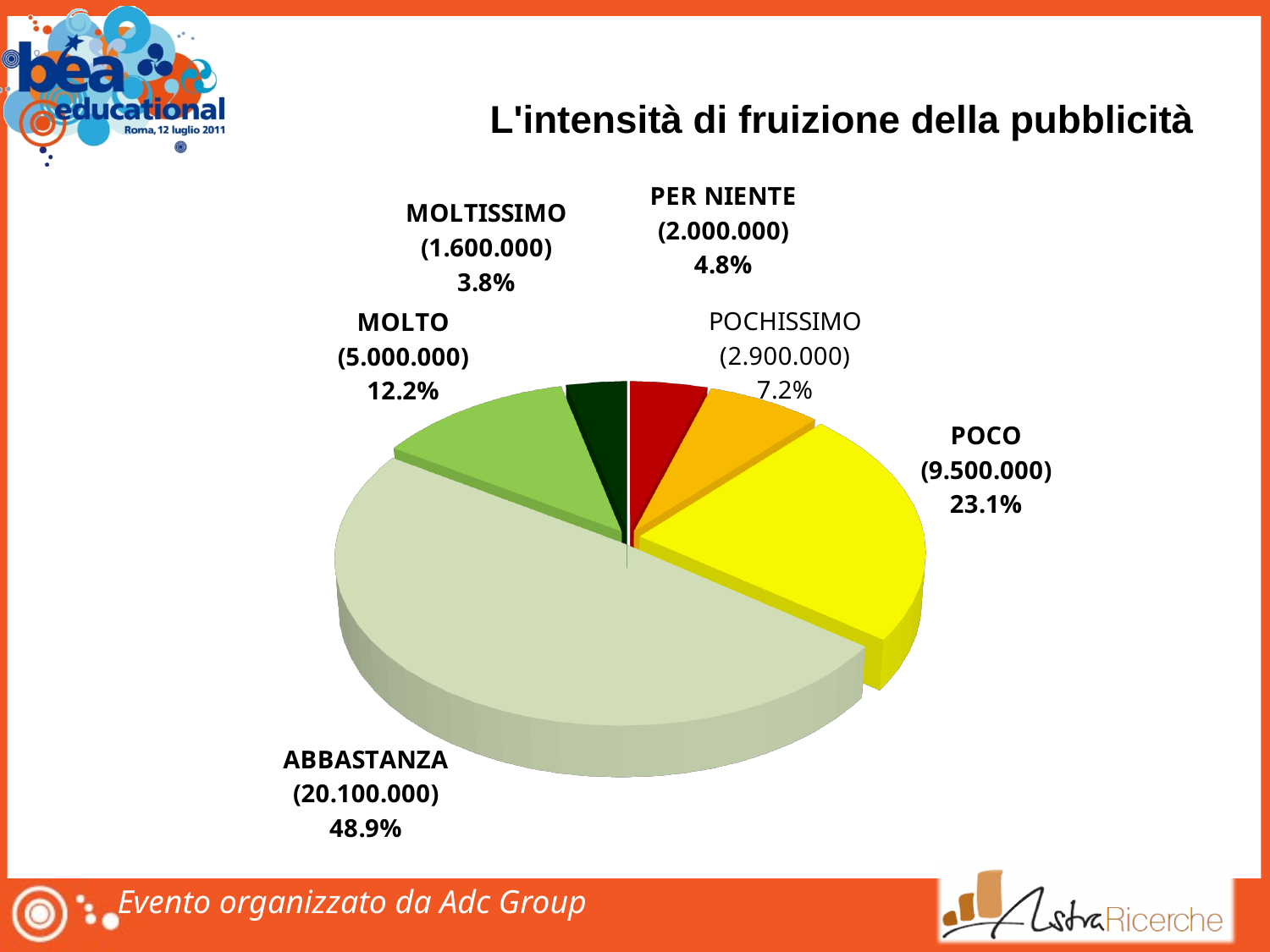
How many slices does the pie chart have? 6 Which category has the largest slice? ABBASTANZA What percentage share does the ABBASTANZA slice have? 48.9% What kind of chart is shown on the slide? pie chart What is the title of the chart? L'intensità di fruizione della pubblicità What percentage is shown for MOLTO? 12.2% What is the value shown for POCO? 9.500.000 Which is larger, POCHISSIMO or PER NIENTE? POCHISSIMO What is the value shown for PER NIENTE? 2.000.000 What is the difference in percentage points between POCO and MOLTO? 10.9 What is the value shown for MOLTISSIMO? 1.600.000 Which category has the smallest slice? MOLTISSIMO